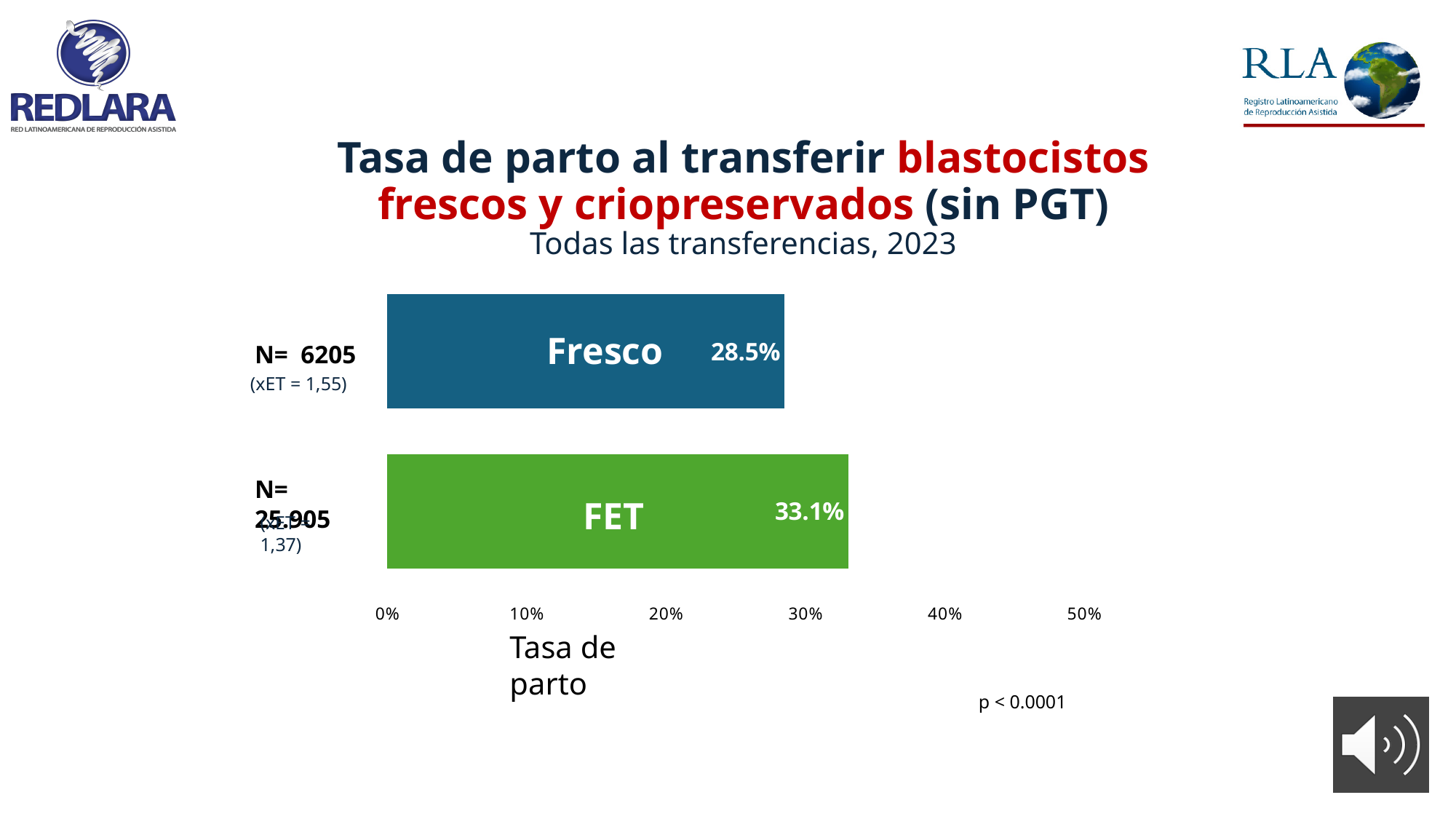
Which category has the higher delivery rate, Fresco or FET? FET What is the difference in delivery rate between FET and Fresco? 4.6% Which category has the lowest delivery rate? Fresco What is the delivery rate (tasa de parto) for Fresco? 28.5% How many bars are shown in the chart? 2 What is the N (number of transfers) for the Fresco group? 6205 What kind of chart is shown on the slide? bar chart Is the value for Fresco greater or less than 30%? less Is the value for FET greater or less than 30%? greater What is the delivery rate (tasa de parto) for FET? 33.1% What is the highest value shown on the x axis? 50%